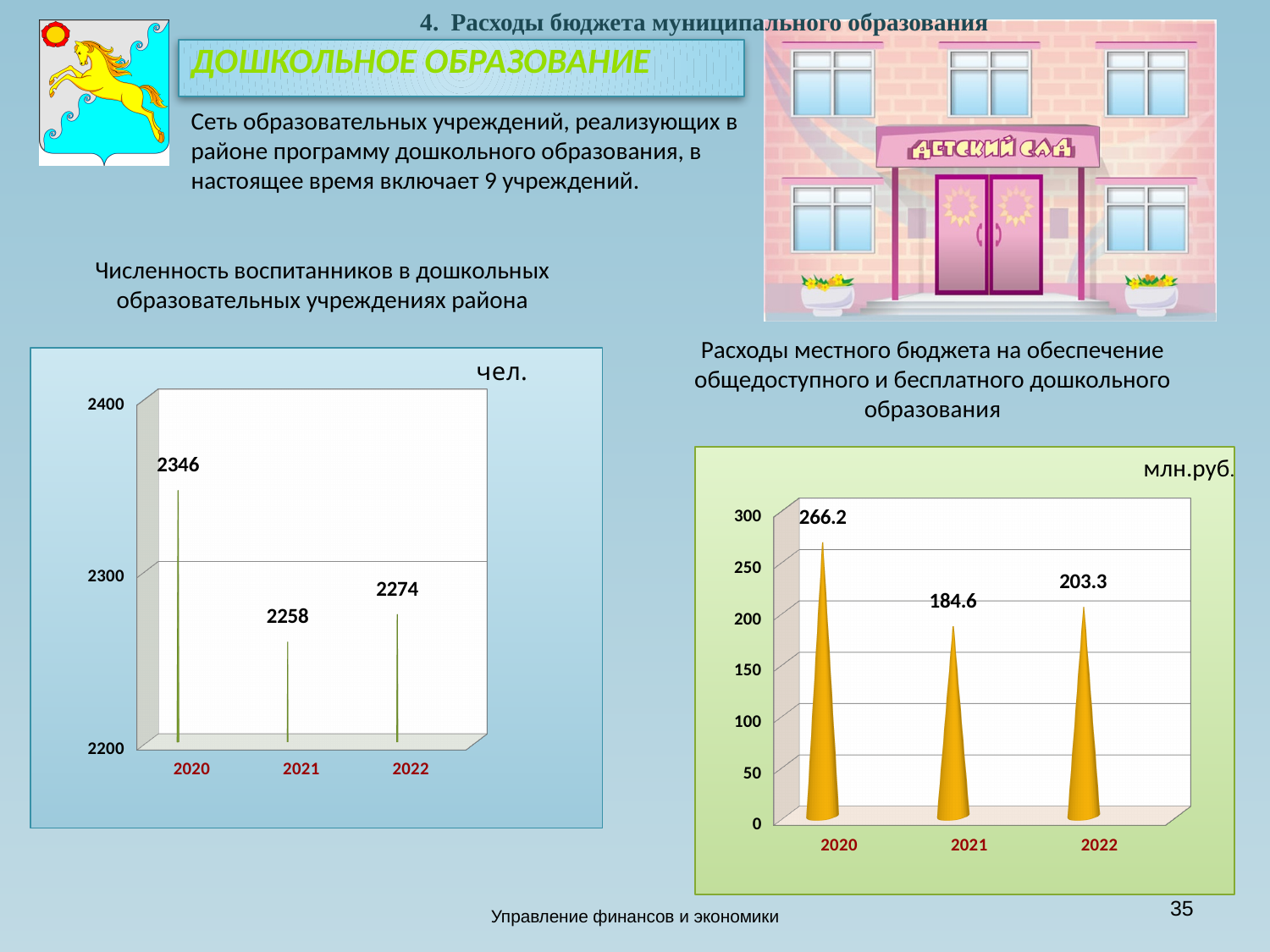
On the chart 'Численность воспитанников в дошкольных образовательных учреждениях района', what is the value for 2021? 2258 On the chart 'Численность воспитанников в дошкольных образовательных учреждениях района', how many years are shown on the x axis? 3 On the chart 'Расходы местного бюджета на обеспечение общедоступного и бесплатного дошкольного образования', is the value for 2021 greater or less than 200? less On the chart 'Численность воспитанников в дошкольных образовательных учреждениях района', what is the value for 2020? 2346 On the chart 'Расходы местного бюджета на обеспечение общедоступного и бесплатного дошкольного образования', what is the difference between the values for 2020 and 2021? 81.6 On the chart 'Численность воспитанников в дошкольных образовательных учреждениях района', what is the difference between the values for 2020 and 2022? 72 On the chart 'Численность воспитанников в дошкольных образовательных учреждениях района', which year has the lowest value? 2021 What unit is shown in the top right corner of the chart 'Расходы местного бюджета на обеспечение общедоступного и бесплатного дошкольного образования'? млн.руб. On the chart 'Расходы местного бюджета на обеспечение общедоступного и бесплатного дошкольного образования', what is the value for 2022? 203.3 On the chart 'Численность воспитанников в дошкольных образовательных учреждениях района', which year has the highest value? 2020 On the chart 'Расходы местного бюджета на обеспечение общедоступного и бесплатного дошкольного образования', which year has the highest value? 2020 On the chart 'Расходы местного бюджета на обеспечение общедоступного и бесплатного дошкольного образования', what is the value for 2021? 184.6